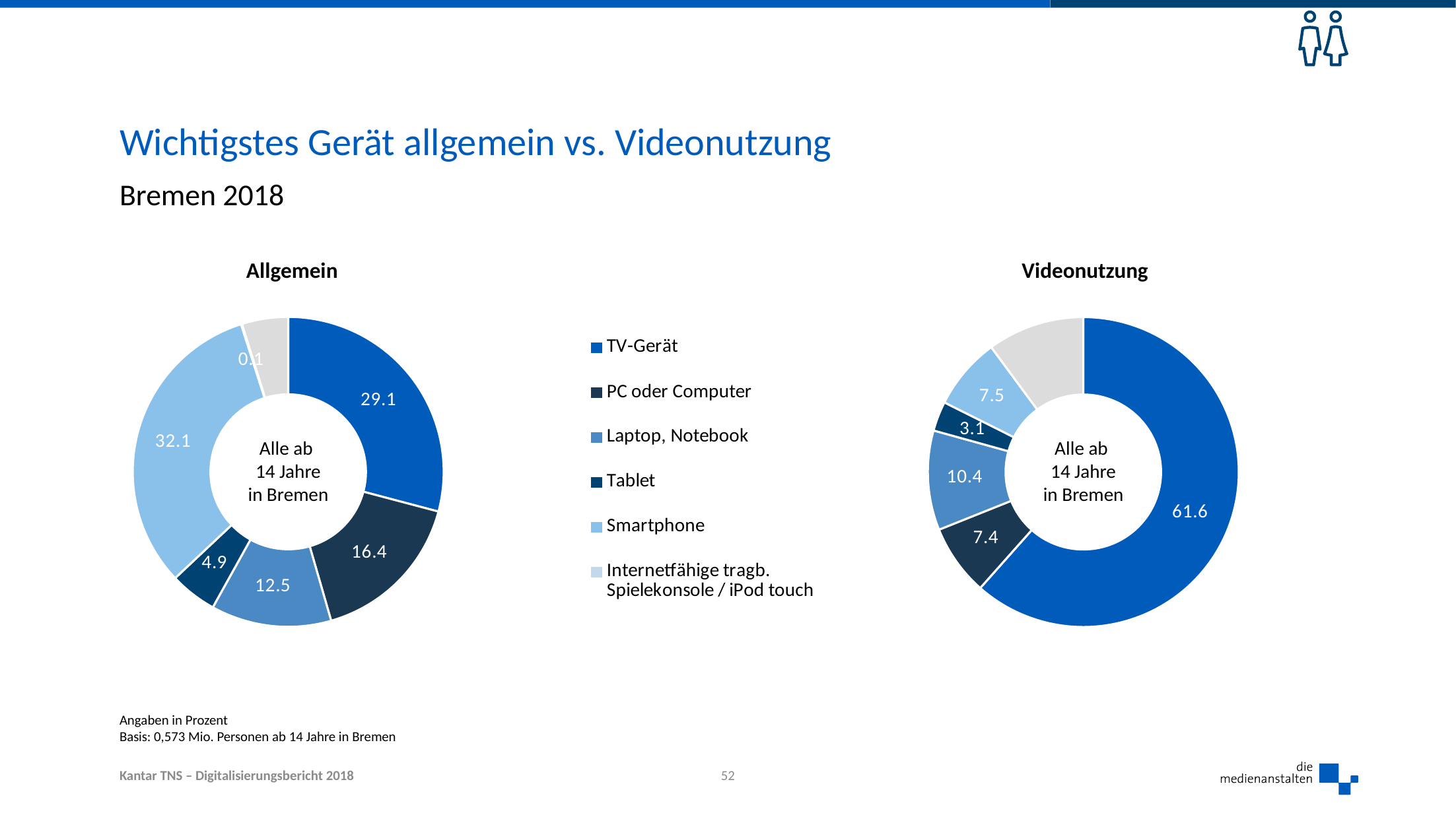
In the Videonutzung chart, what is the value for Laptop, Notebook? 10.4 In the Allgemein chart, what is the difference between the values for PC oder Computer and Laptop, Notebook? 3.9 In the Allgemein chart, which labelled category has the highest value? Smartphone What kind of chart is the Videonutzung chart? Pie chart (donut) In the Videonutzung chart, which category has the highest value? TV-Gerät In the Allgemein chart, what is the value for TV-Gerät? 29.1 How many entries does the legend list? 6 Which is larger in the Allgemein chart: the value for Tablet or the value for Laptop, Notebook? Laptop, Notebook In the Videonutzung chart, what is the value for TV-Gerät? 61.6 In the Videonutzung chart, which labelled category has the lowest value? Tablet In the Videonutzung chart, what is the value for Tablet? 3.1 In the Allgemein chart, what is the value for Smartphone? 32.1